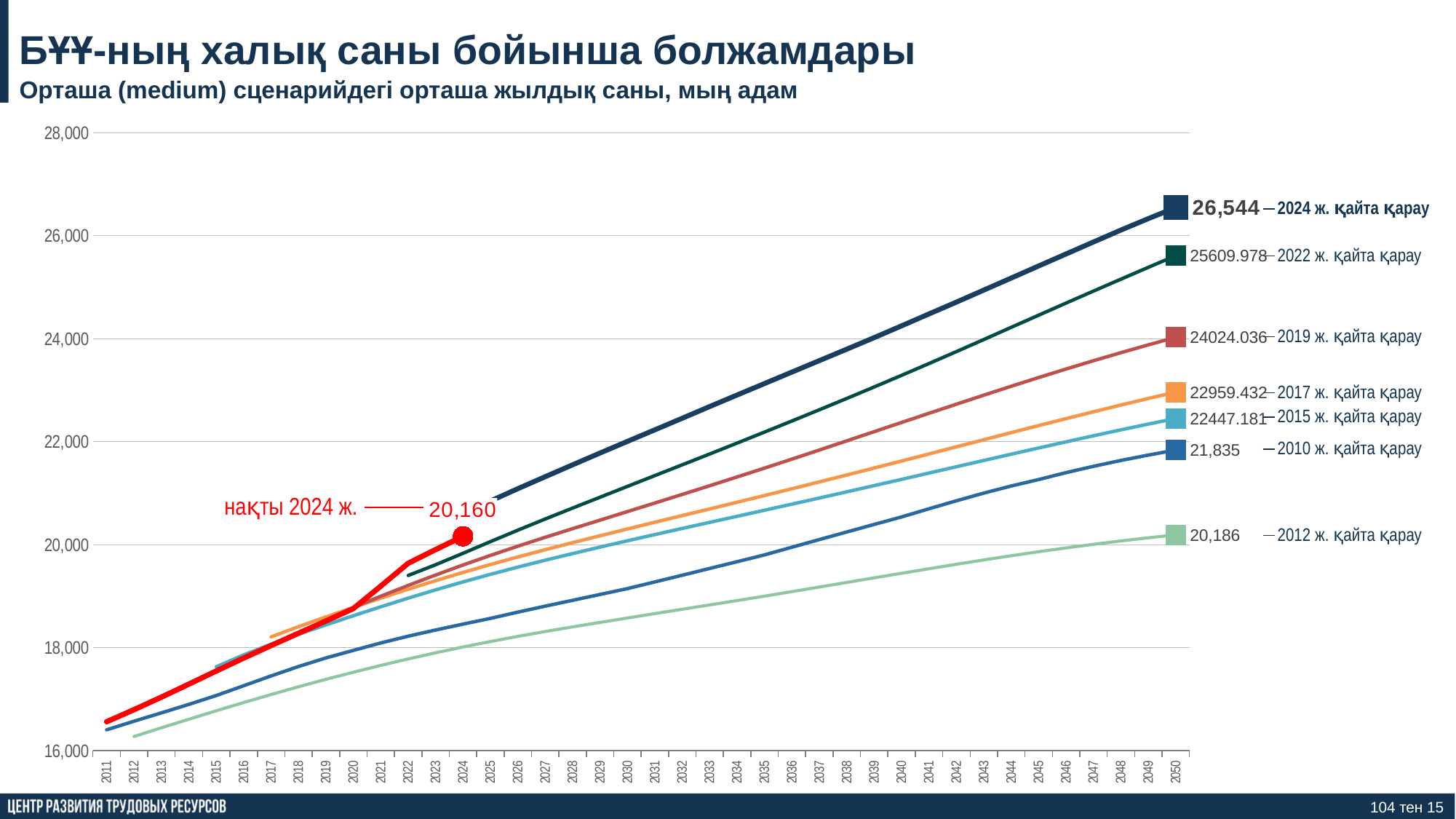
What is the difference between the 2050 values of the 2024 ж. қайта қарау and 2012 ж. қайта қарау lines? 6,358 What is the 2050 value for the 2022 ж. қайта қарау line? 25609.978 How many UN revision (қайта қарау) lines are labelled on the chart? 7 Which has the larger 2050 value: the 2017 ж. қайта қарау line or the 2015 ж. қайта қарау line? 2017 ж. қайта қарау What type of chart is shown on the slide? line chart Is the value of the 2012 ж. қайта қарау line in 2030 greater or less than 20,000? less What value is labelled for нақты 2024 ж. (actual 2024)? 20,160 Do the projection lines rise or fall from 2011 to 2050? rise Which revision line has the highest value in 2050? 2024 ж. қайта қарау What is the 2050 value for the 2012 ж. қайта қарау line? 20,186 What is the 2050 value for the 2024 ж. қайта қарау line? 26,544 Which revision line has the lowest value in 2050? 2012 ж. қайта қарау